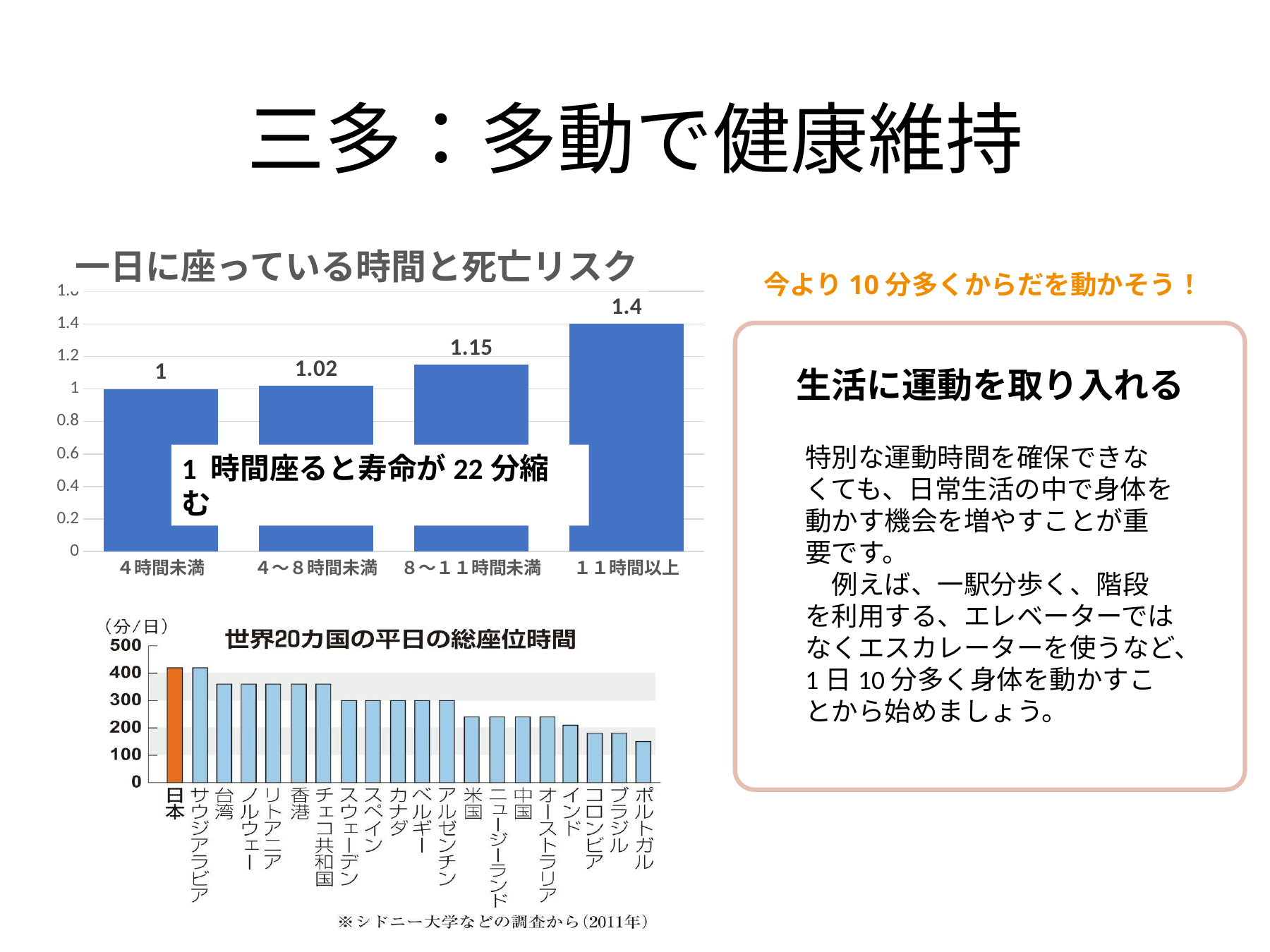
In the chart titled 世界20カ国の平日の総座位時間, is the value for 日本 greater or less than 300? greater In the chart titled 世界20カ国の平日の総座位時間, how many countries are shown? 20 In the chart titled 一日に座っている時間と死亡リスク, do the values rise or fall as sitting time increases along the x axis? rise In the chart titled 一日に座っている時間と死亡リスク, what is the value for 8～１１時間未満? 1.15 In the chart titled 一日に座っている時間と死亡リスク, how many categories are shown on the x axis? 4 In the chart titled 世界20カ国の平日の総座位時間, which country's bar is coloured orange? 日本 In the chart titled 世界20カ国の平日の総座位時間, which country has the lowest value? ポルトガル In the chart titled 一日に座っている時間と死亡リスク, which category has the lowest value? ４時間未満 What kind of chart is the one titled 世界20カ国の平日の総座位時間? bar chart In the chart titled 一日に座っている時間と死亡リスク, which category has the highest value? １１時間以上 In the chart titled 一日に座っている時間と死亡リスク, what is the difference between the values for １１時間以上 and ４時間未満? 0.4 In the chart titled 一日に座っている時間と死亡リスク, what is the value for １１時間以上? 1.4